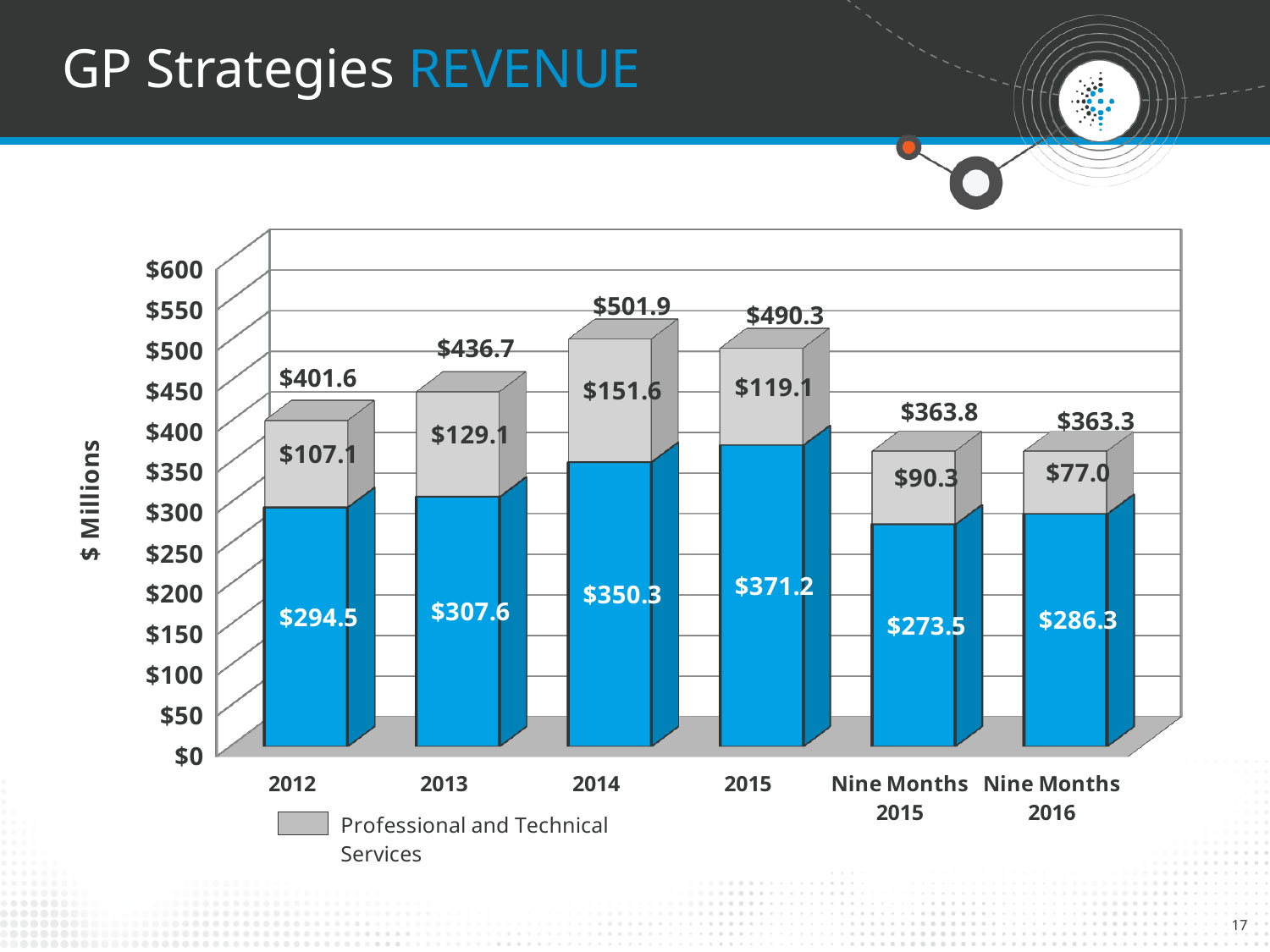
Which category has the highest total revenue? 2014 What is the value of the blue (bottom) segment for Nine Months 2016? $286.3 How many categories are shown on the x axis? 6 What is the Professional and Technical Services value for Nine Months 2015? $90.3 Do the total revenue values rise or fall from 2012 to 2014? Rise What is the Professional and Technical Services value for 2014? $151.6 Which is larger, the total revenue for 2015 or for 2014? 2014 What is the total revenue shown above the bar for 2013? $436.7 What is the difference between the total revenue for 2014 and 2013? $65.2 Which category has the lowest Professional and Technical Services value? Nine Months 2016 What kind of chart is shown on the slide? Stacked bar chart Is the blue (bottom) segment for 2015 greater or less than $350? greater